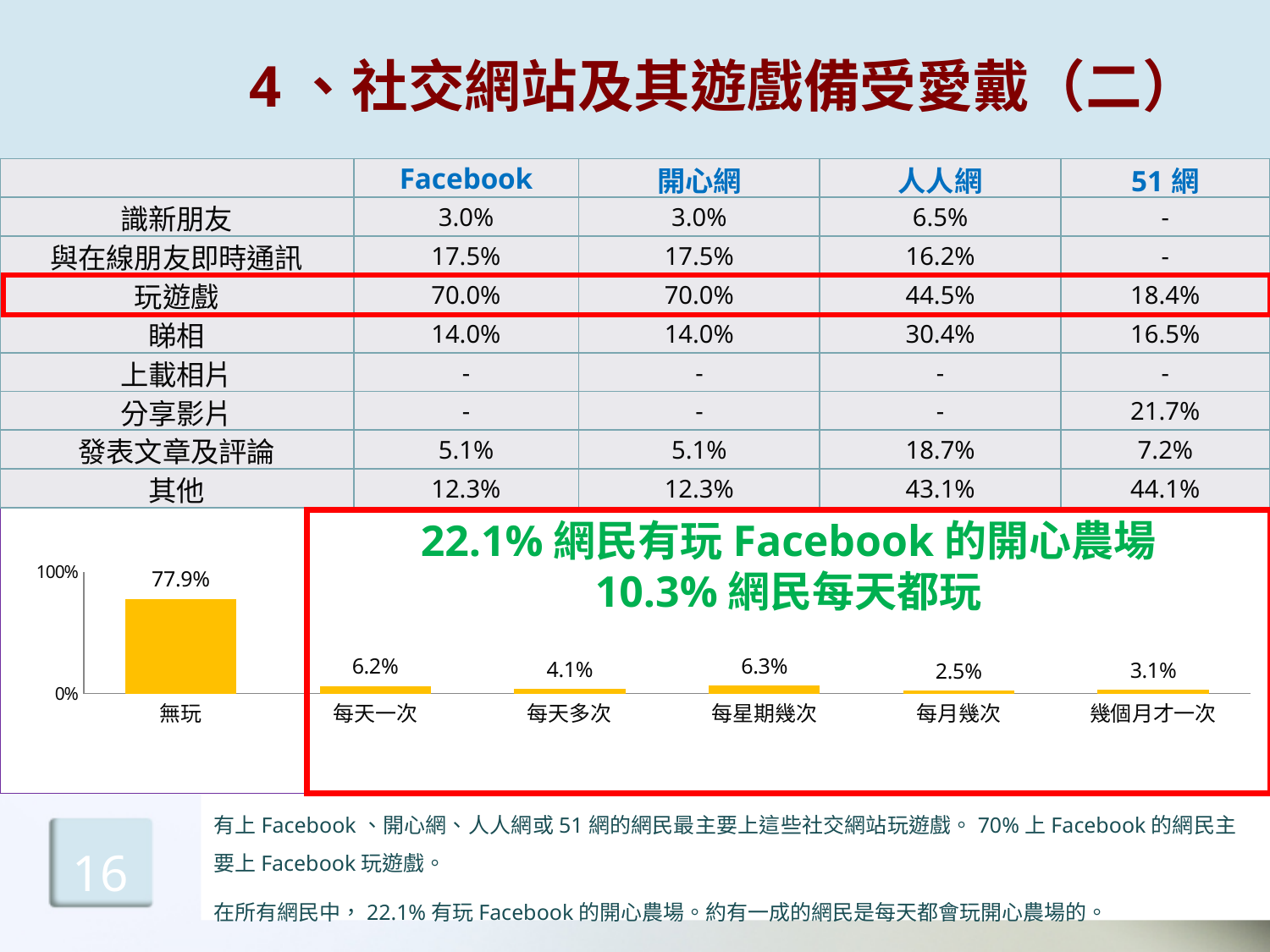
In the bar chart, what is the value for 每月幾次? 2.5% In the bar chart, what is the value for 每星期幾次? 6.3% In the bar chart, which is larger, the value for 每天多次 or the value for 幾個月才一次? 每天多次 In the bar chart, what is the value for 幾個月才一次? 3.1% In the bar chart, what is the value for 每天一次? 6.2% In the bar chart, what is the value for 每天多次? 4.1% In the bar chart, what is the value for 無玩? 77.9% In the bar chart, which category has the highest value? 無玩 In the bar chart, which category has the lowest value? 每月幾次 In the bar chart, what is the difference between the values for 無玩 and 每天一次? 71.7% In the bar chart, how many categories are shown on the x axis? 6 What kind of chart is shown at the bottom of the slide? bar chart